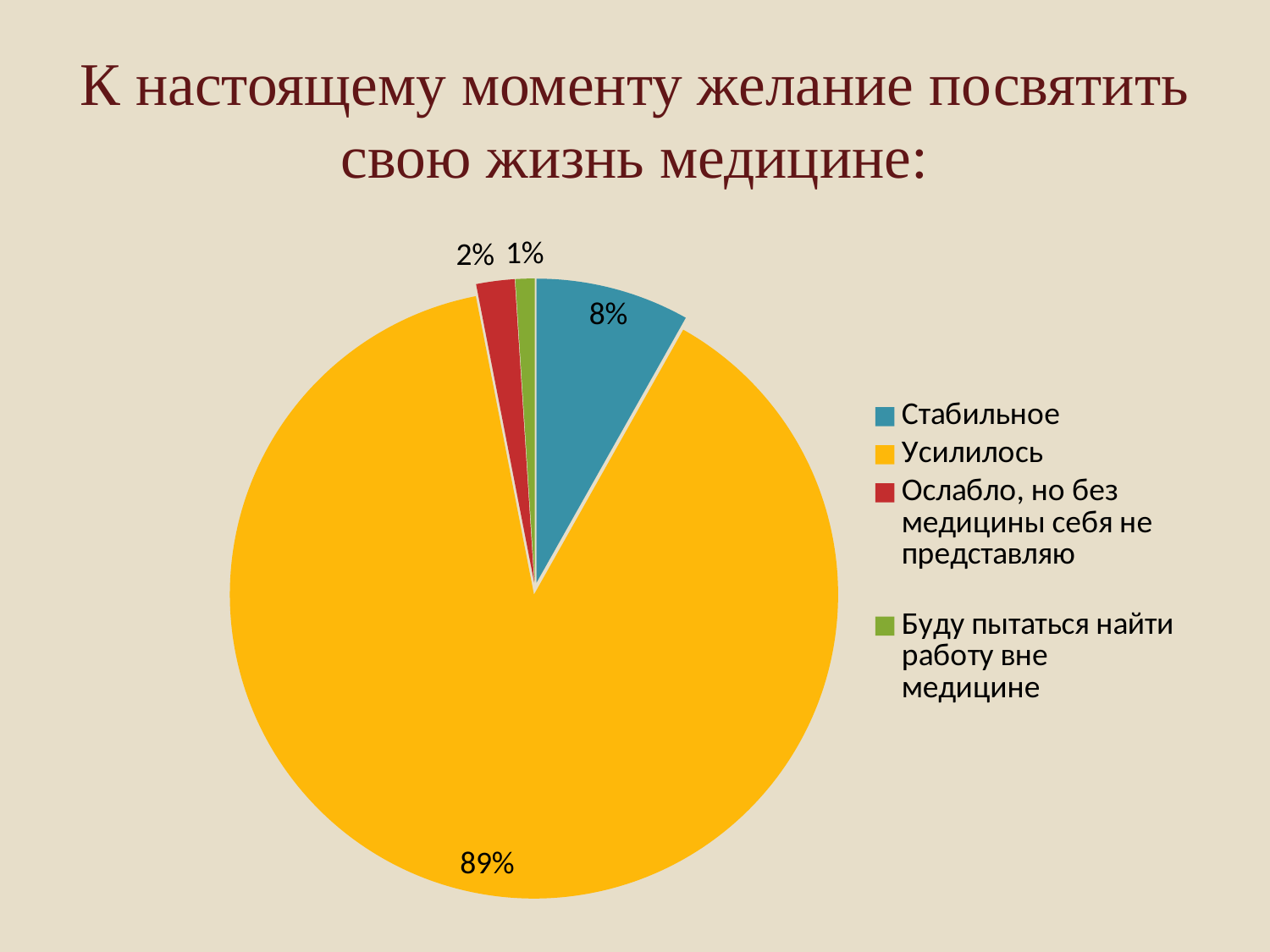
What share of the pie does "Ослабло, но без медицины себя не представляю" take? 2% Which category has the largest slice of the pie? Усилилось How many categories does the pie chart have? 4 What share of the pie does "Усилилось" take? 89% What is the title of the slide containing the chart? К настоящему моменту желание посвятить свою жизнь медицине: What kind of chart is shown on the slide? pie chart Which is larger: the share of "Стабильное" or the share of "Ослабло, но без медицины себя не представляю"? Стабильное What share of the pie does "Стабильное" take? 8% Which category has the smallest slice of the pie? Буду пытаться найти работу вне медицине What colour is the slice for "Усилилось"? yellow What is the difference between the shares of "Усилилось" and "Стабильное"? 81%